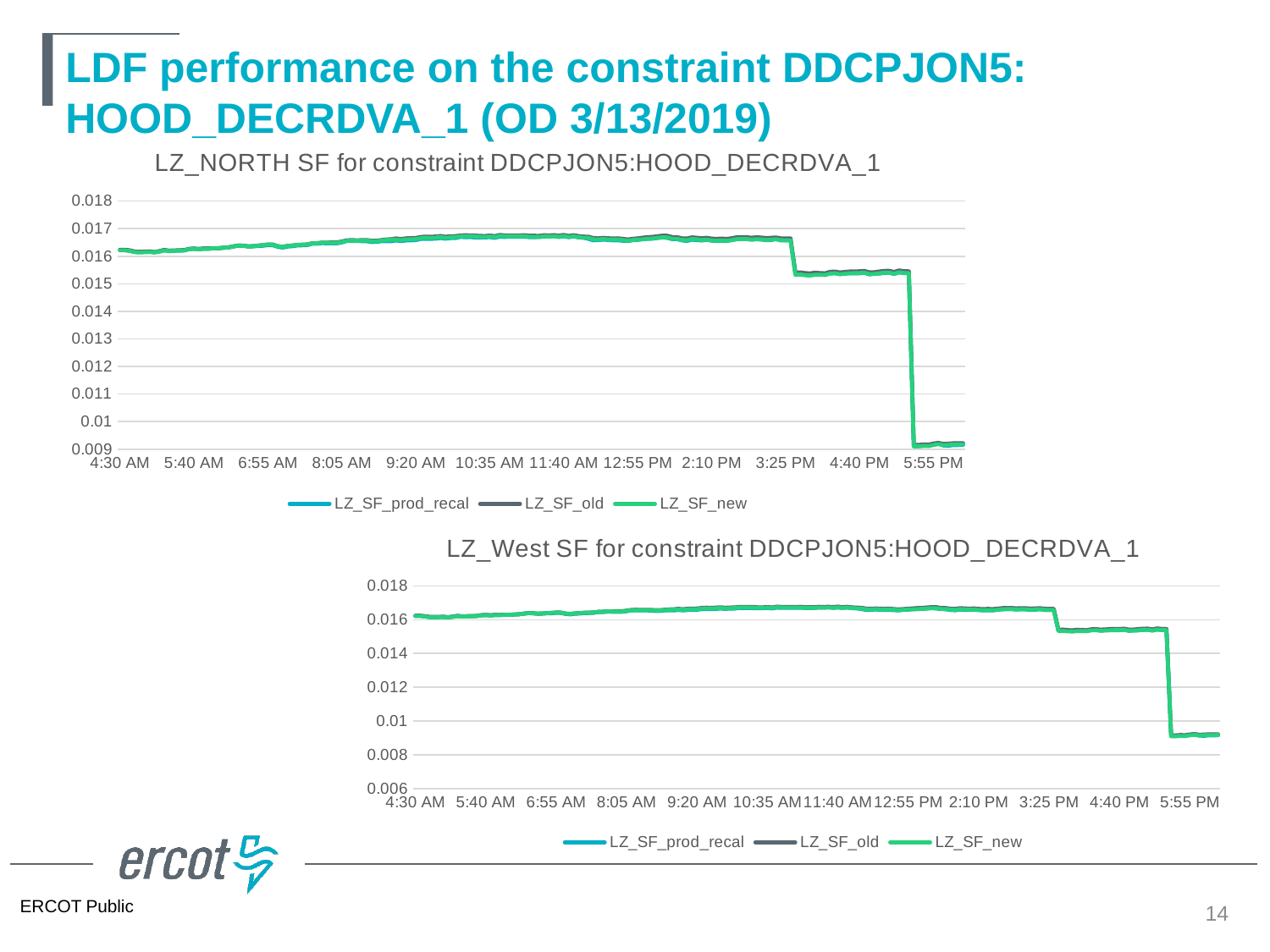
In the bottom chart (LZ_West SF), is the value at 5:55 PM greater or less than 0.01? less In the top chart (LZ_NORTH SF), do the values overall rise or fall from 4:30 AM to 5:55 PM? fall In the bottom chart (LZ_West SF), is the value at 9:20 AM greater or less than 0.014? greater In the top chart (LZ_NORTH SF), is the value at 4:40 PM greater or less than 0.016? less How many series does the legend of the top chart (LZ_NORTH SF) list? 3 What kind of chart is the top chart titled 'LZ_NORTH SF for constraint DDCPJON5:HOOD_DECRDVA_1'? line chart What kind of chart is the bottom chart titled 'LZ_West SF for constraint DDCPJON5:HOOD_DECRDVA_1'? line chart How many series does the legend of the bottom chart (LZ_West SF) list? 3 In the bottom chart (LZ_West SF), do the values overall rise or fall from 4:30 AM to 5:55 PM? fall What are the three legend entries of the bottom chart (LZ_West SF)? LZ_SF_prod_recal, LZ_SF_old, LZ_SF_new